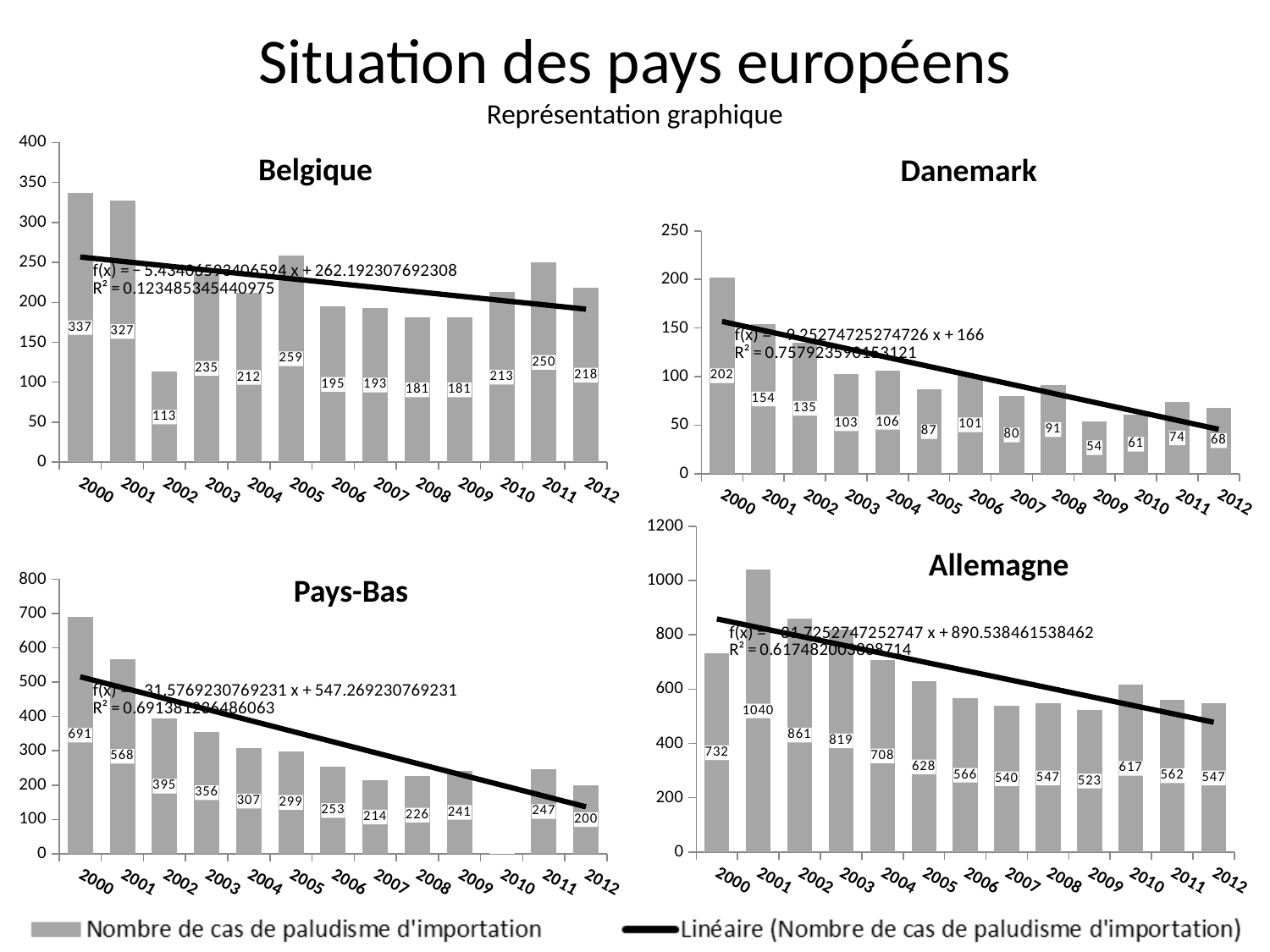
In the Pays-Bas chart, which is larger, the value for 2008 or the value for 2009? 2009 In the Allemagne chart, what is the value for 2010? 617 In the Danemark chart, what is the value for 2009? 54 In the Danemark chart, which year has the lowest value? 2009 In the Danemark chart, what is the difference between the values for 2000 and 2012? 134 In the Allemagne chart, what is the difference between the values for 2001 and 2002? 179 In the Belgique chart, which year has the highest value? 2000 How many series does the legend at the bottom of the slide list? 2 In the Allemagne chart, which year has the highest value? 2001 What kind of chart is the Belgique chart? Bar chart In the Pays-Bas chart, what is the value for 2000? 691 In the Belgique chart, what is the value for 2002? 113